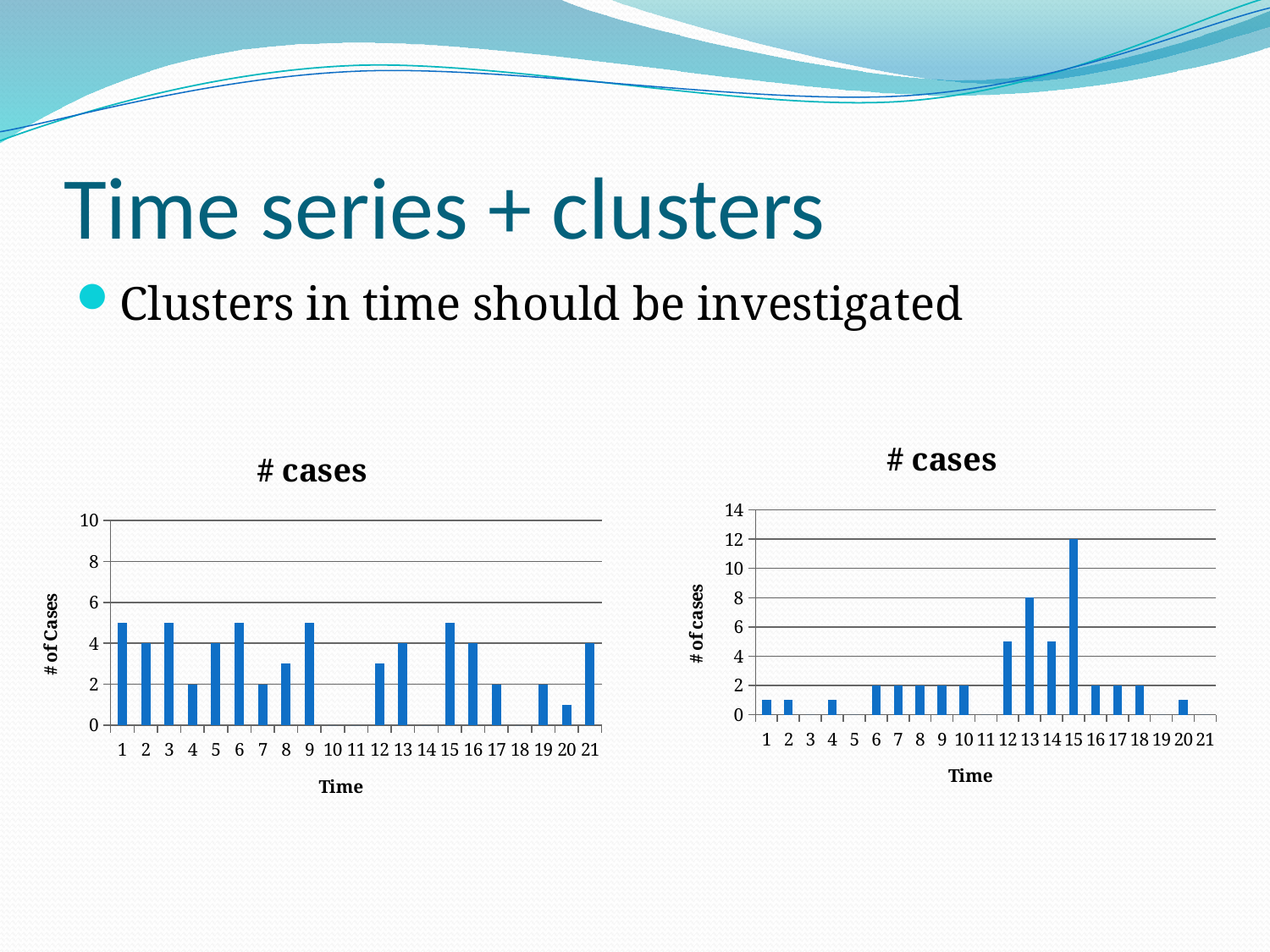
In the chart on the left, is the value for time 1 greater or less than 4? greater In the chart on the right, which has more cases, time 14 or time 15? time 15 In the chart on the right, at which time is the number of cases highest? 15 In the chart on the left, what is the number of cases at time 4? 2 In the chart on the right, what is the number of cases at time 15? 12 In the chart on the right, what is the difference between the number of cases at time 15 and at time 13? 4 How many time points are shown on the x axis of the chart on the right? 21 What kind of chart is the chart on the left of the slide? bar chart In the chart on the right, what is the number of cases at time 13? 8 What is the title of the chart on the left? # cases In the chart on the left, what is the number of cases at time 2? 4 In the chart on the right, is the value for time 12 greater or less than 4? greater